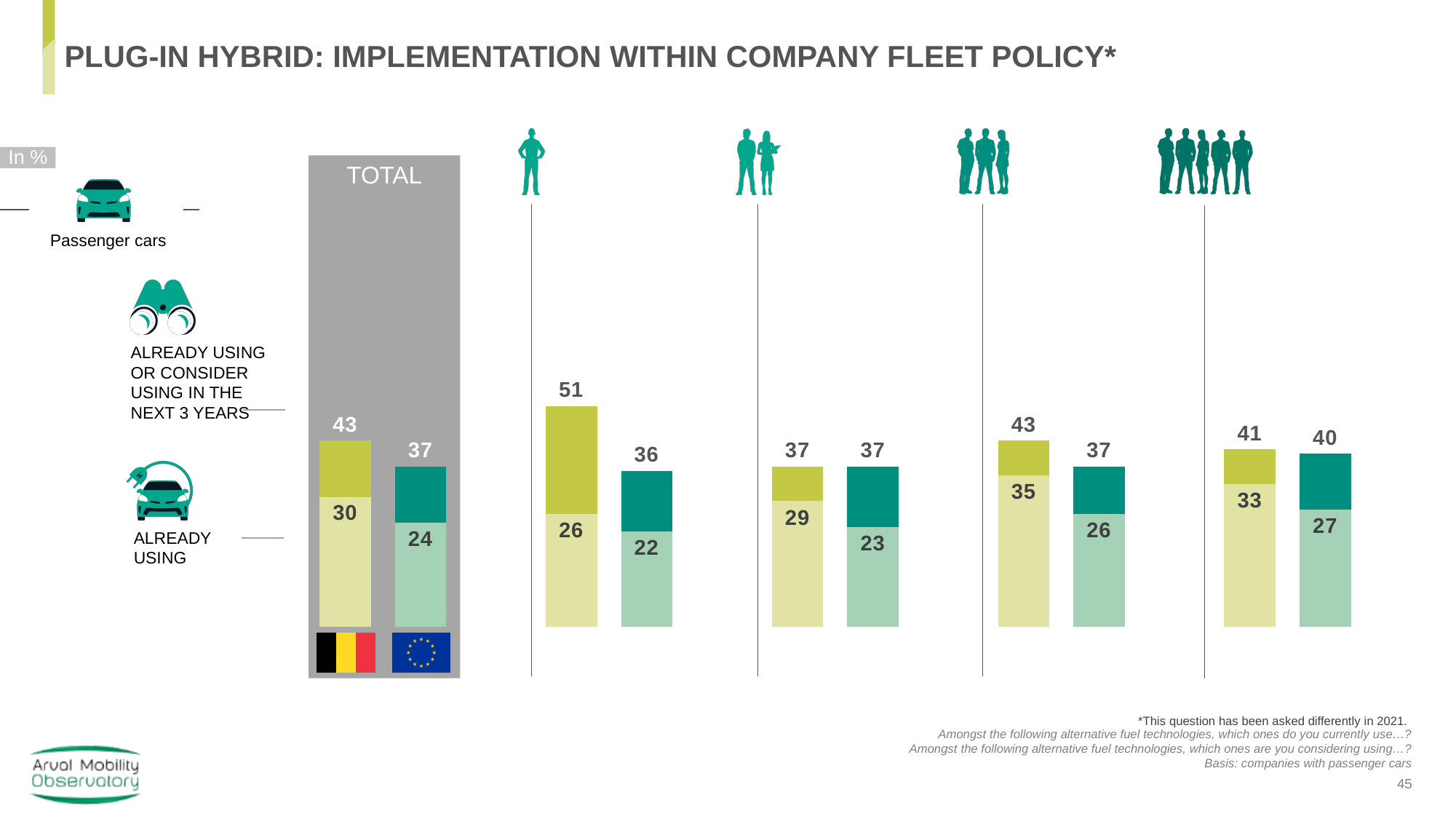
What kind of chart is shown on the slide? Bar chart In the TOTAL column, what percentage of European companies are already using plug-in hybrids? 24 In the TOTAL column, which is higher for 'already using': Belgium or Europe? Belgium What is the highest 'already using or consider using in the next 3 years' value shown on the slide? 51 In the rightmost group of bars, what is the European value for 'already using or consider using in the next 3 years'? 40 In the rightmost group of bars, what is the difference between the Belgian and European values for 'already using or consider using in the next 3 years'? 1 In the TOTAL column, what percentage of Belgian companies are already using or consider using plug-in hybrids in the next 3 years? 43 In the first group of bars to the right of the TOTAL column (single-person icon), what is the Belgian value for 'already using or consider using in the next 3 years'? 51 In what unit are the values on the chart expressed? In % How many groups of bars are shown on the chart, including the TOTAL column? 5 What is the lowest 'already using' value shown on the slide? 22 In the TOTAL column, what is the difference between Belgium and Europe for 'already using or consider using in the next 3 years'? 6